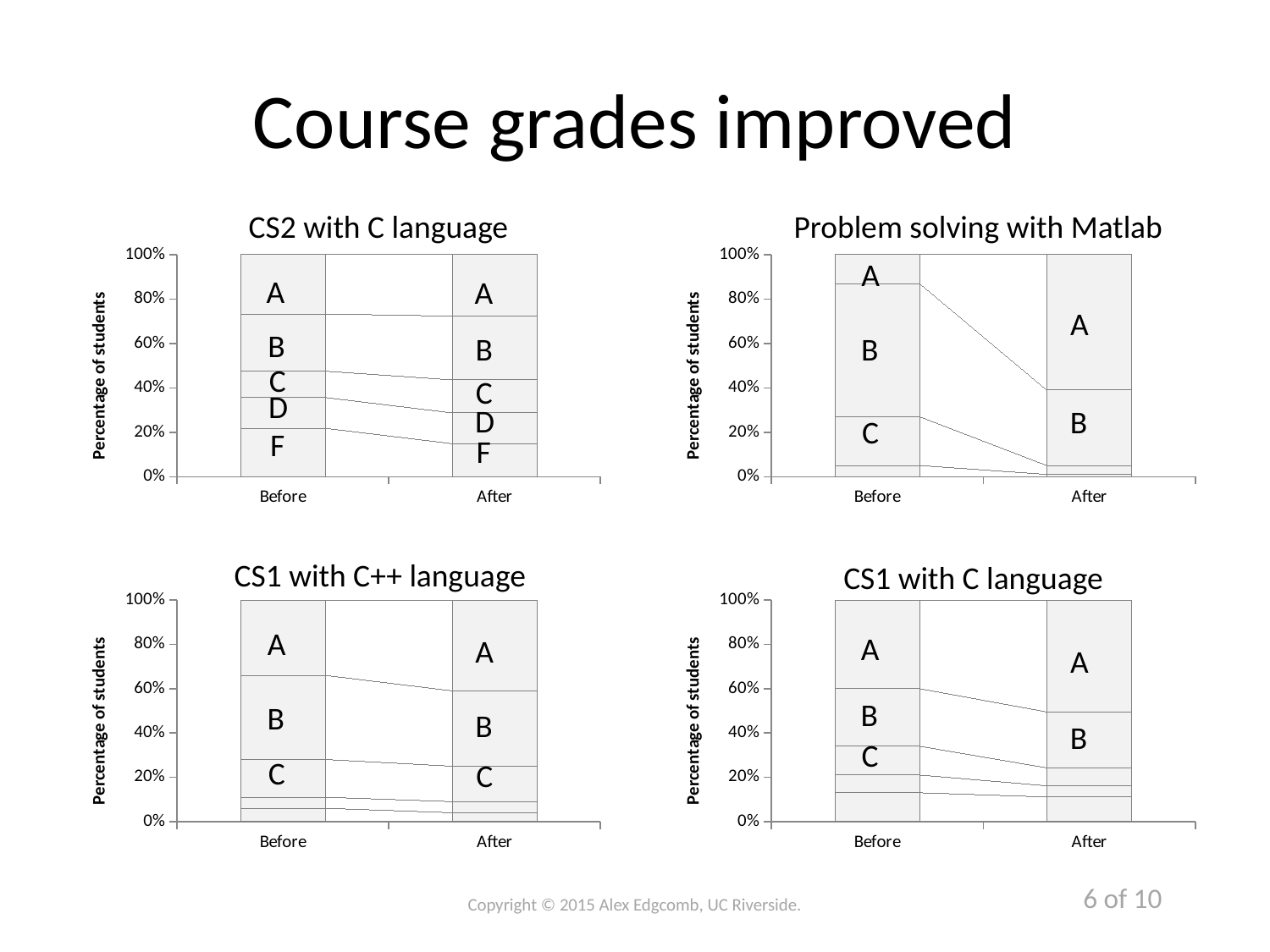
Which grade letters are labeled in the After bar of the "Problem solving with Matlab" chart? A and B How many categories are on the x axis of the "CS1 with C language" chart? 2 In the "Problem solving with Matlab" chart, is the share of A grades in the After bar greater or less than 40%? greater How many grade segments are labeled in the Before bar of the "CS2 with C language" chart? 5 What are the two x-axis categories in the "Problem solving with Matlab" chart? Before and After In the "Problem solving with Matlab" chart, is the A segment larger in the Before bar or the After bar? After What kind of chart is the "CS2 with C language" chart? Stacked bar chart In the "CS2 with C language" chart, is the F segment larger in the Before bar or the After bar? Before What is the y-axis title of the "CS1 with C++ language" chart? Percentage of students How many charts are shown on the slide? 4 In the "CS1 with C++ language" chart, is the share of A grades in the Before bar greater or less than 20%? greater In the "CS1 with C language" chart, is the share of B grades in the After bar greater or less than 40%? less